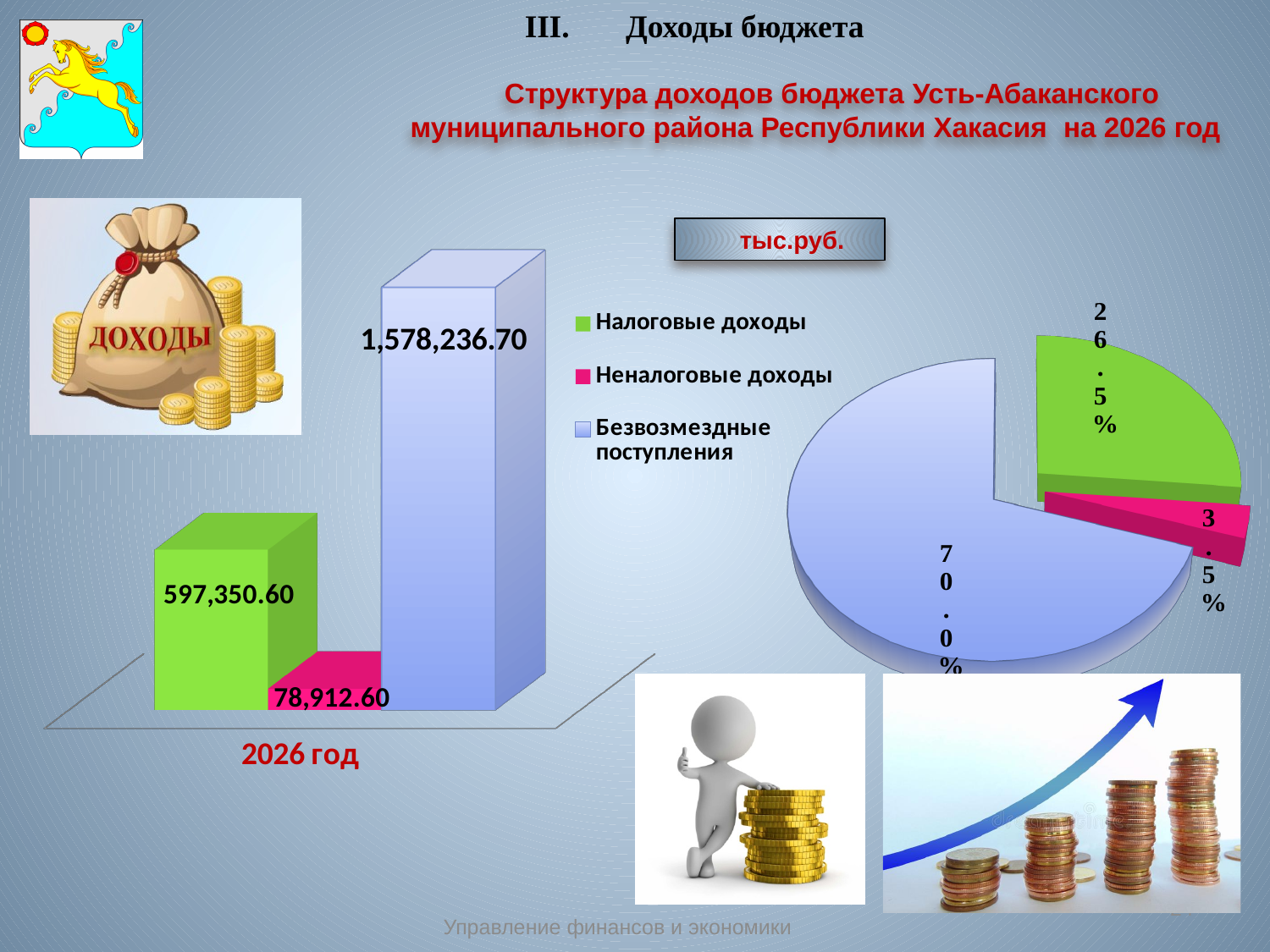
On the pie chart, what share does Налоговые доходы have? 26.5% What kind of chart is the chart on the left side of the slide? Bar chart On the bar chart, which is larger: Налоговые доходы or Неналоговые доходы? Налоговые доходы On the bar chart, which series has the highest value? Безвозмездные поступления How many series does the legend list? 3 On the pie chart, what share does Неналоговые доходы have? 3.5% On the bar chart, which series has the lowest value? Неналоговые доходы On the bar chart, what is the value for Неналоговые доходы in 2026 год? 78,912.60 On the bar chart, what is the value for Налоговые доходы in 2026 год? 597,350.60 On the bar chart, what is the difference between Безвозмездные поступления and Налоговые доходы? 980,886.10 On the bar chart, what is the value for Безвозмездные поступления in 2026 год? 1,578,236.70 On the pie chart, what share does Безвозмездные поступления have? 70.0%